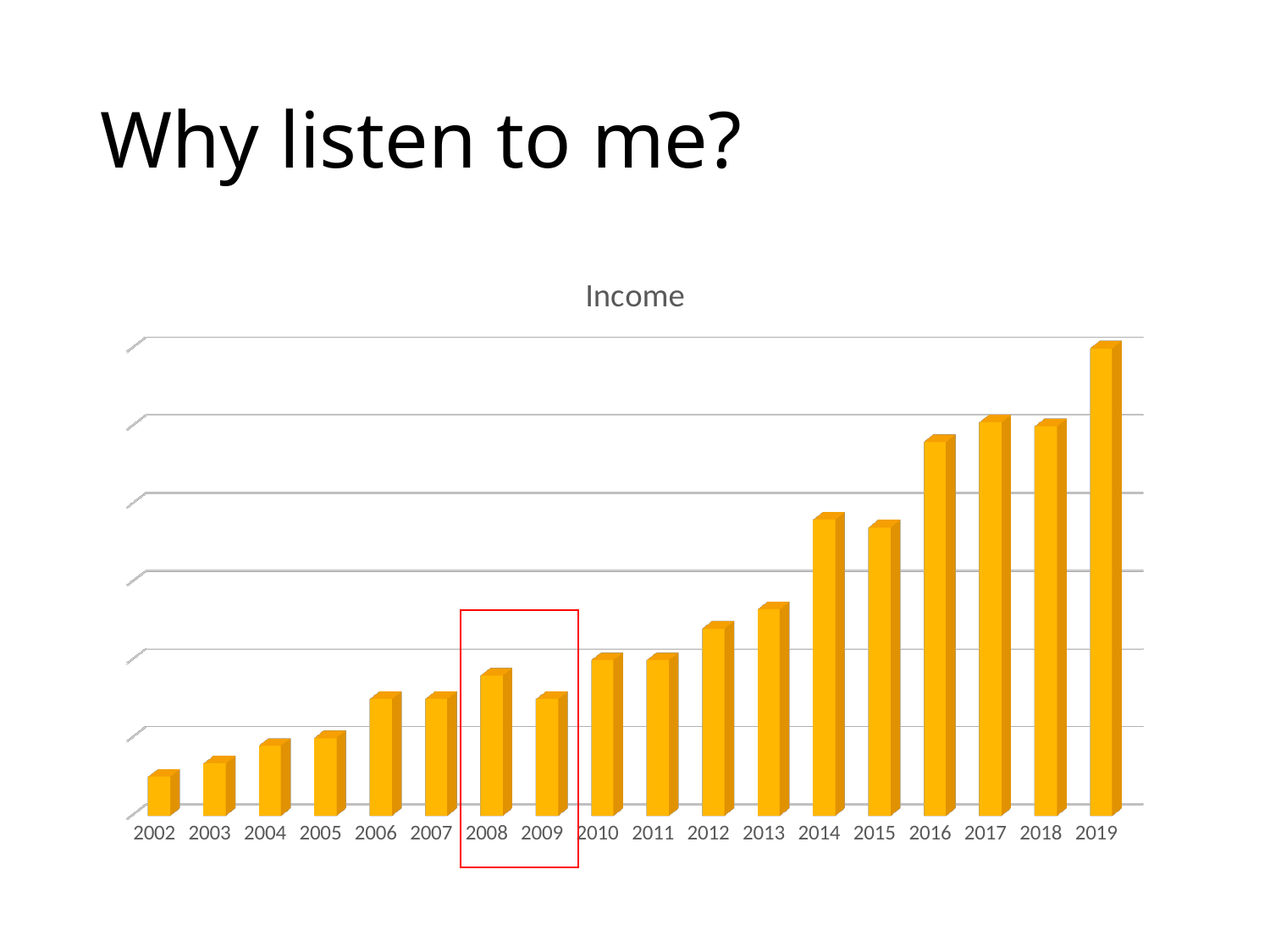
How many years are plotted on the x axis of the Income chart? 18 Overall, do the income bars rise or fall from 2002 to 2019? Rise What kind of chart is shown on the slide? Bar chart Which year has the lowest income bar? 2002 Which year has the highest income bar? 2019 Which year has the larger income bar, 2008 or 2009? 2008 What is the first year shown on the x axis? 2002 Which year has the larger income bar, 2013 or 2019? 2019 Which two years are outlined by the red box on the chart? 2008 and 2009 Which year has the larger income bar, 2014 or 2009? 2014 What is the title of the chart? Income